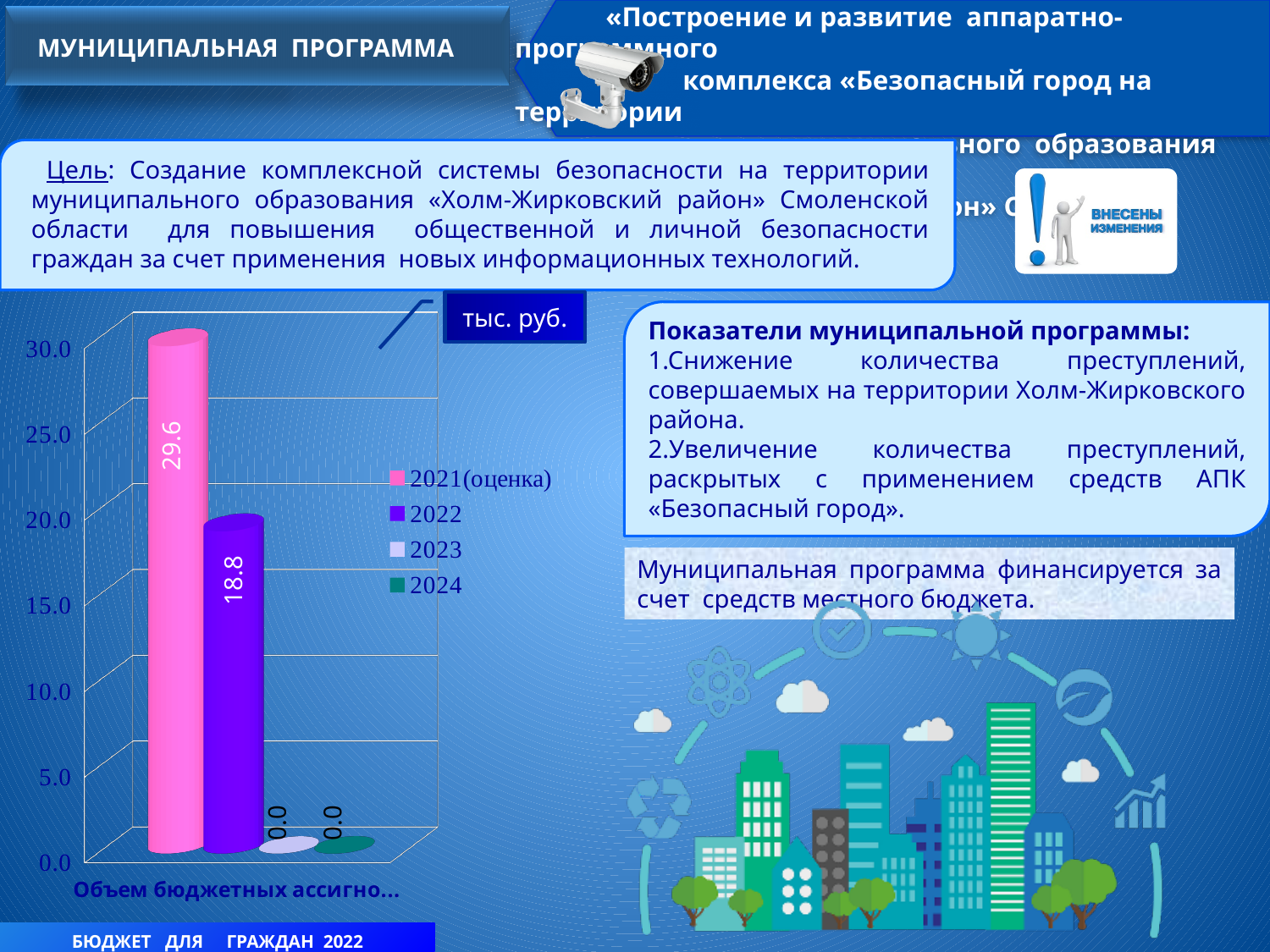
What is the value for 2023 in the chart? 0.0 How many series does the chart legend list? 4 What kind of chart is shown on the slide? bar chart Is the value for 2022 greater or less than 20.0? less What is the value for 2021(оценка) in the chart? 29.6 Which series has the highest value in the chart? 2021(оценка) What is the value for 2024 in the chart? 0.0 Which is larger, the value for 2021(оценка) or the value for 2022? 2021(оценка) What colour is the bar for 2022 in the chart? purple What unit is shown in the box above the chart? тыс. руб. What is the difference between the values for 2021(оценка) and 2022? 10.8 What is the value for 2022 in the chart? 18.8